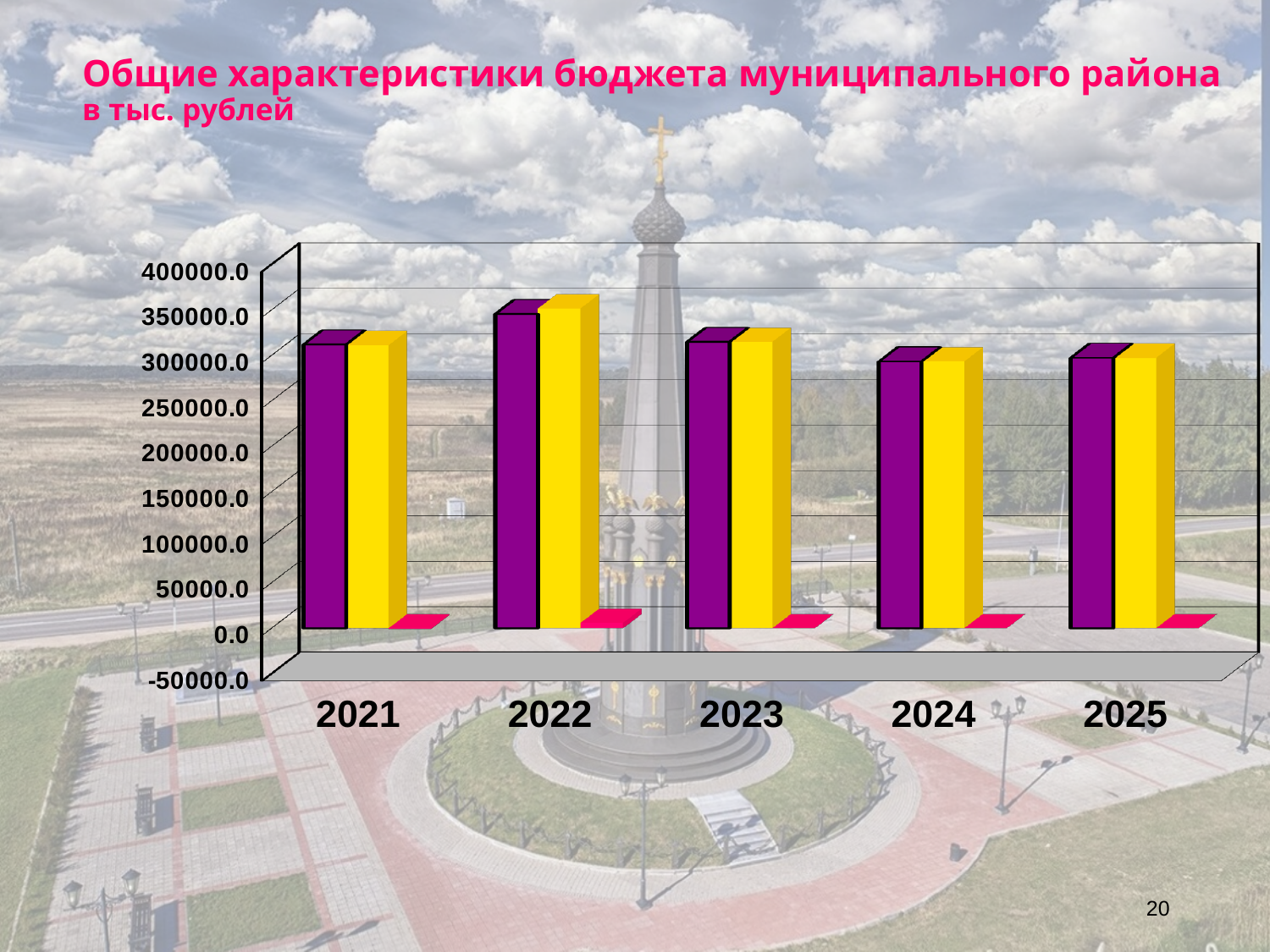
Is the yellow bar for 2021 greater or less than 250000.0? greater What kind of chart is shown on the slide? bar chart How many years are shown on the x axis of the chart? 5 Which year has the tallest yellow bar? 2022 Which is larger, the yellow bar for 2023 or the yellow bar for 2022? 2022 Which is larger, the purple bar for 2022 or the purple bar for 2024? 2022 In what units are the values on the chart given, according to the slide? в тыс. рублей Is the purple bar for 2024 greater or less than 350000.0? less What is the title of the chart on the slide? Общие характеристики бюджета муниципального района Is the yellow bar for 2022 greater or less than 400000.0? less Which year has the tallest purple bar? 2022